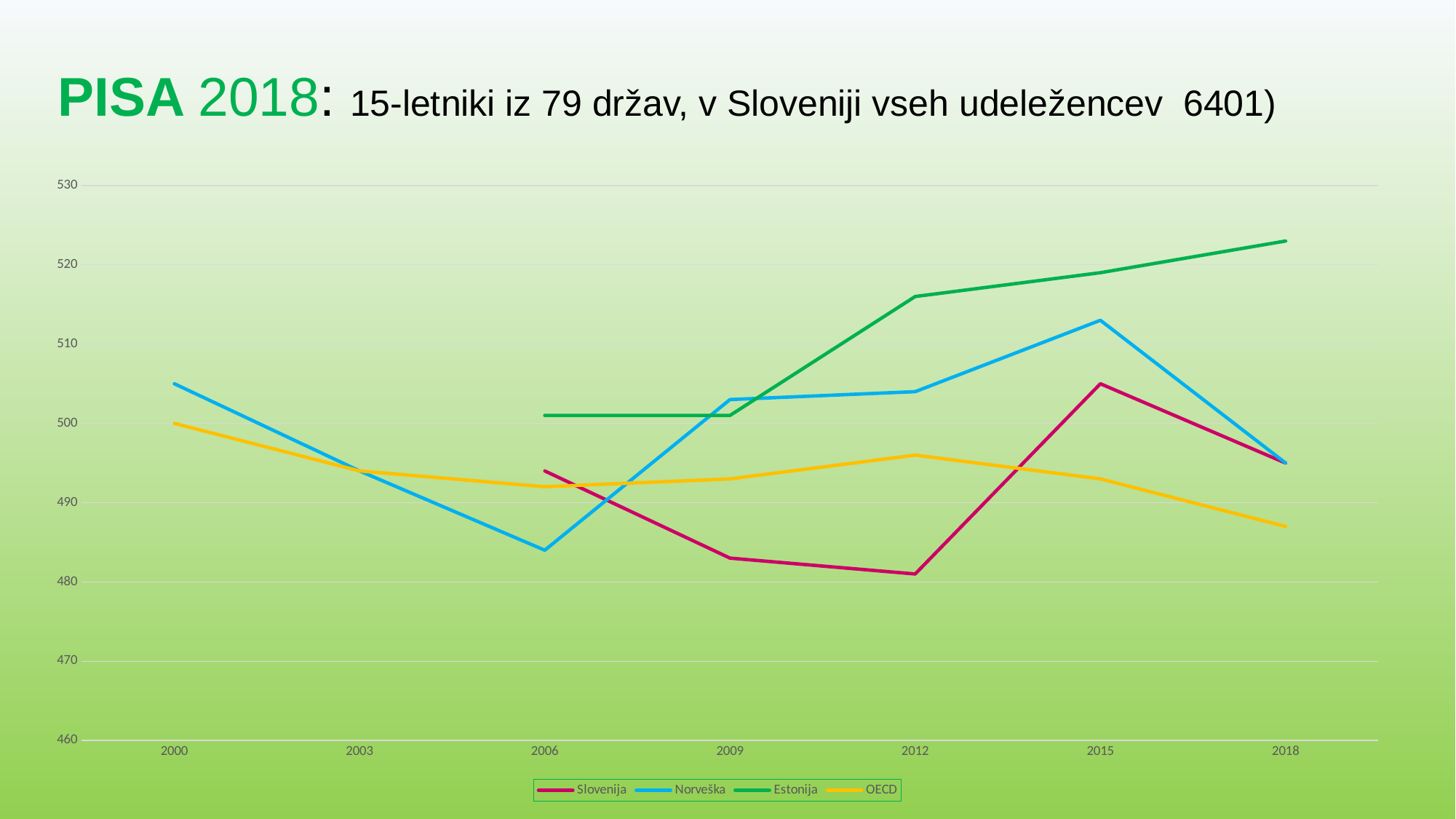
Does the Estonija line rise or fall from 2006 to 2018? rise Is the value for Slovenija in 2012 greater or less than 490? less How many series does the legend list? 4 Which series has the highest value in 2018? Estonija In 2009, which is larger: the value for Slovenija or the value for OECD? OECD Which series has the lowest value in 2012? Slovenija Which series has the lowest value in 2018? OECD Which series is drawn in yellow? OECD How many years are shown on the x axis? 7 Is the value for Estonija in 2018 greater or less than 520? greater What kind of chart is shown on the slide? line chart Is the value for Norveška in 2006 greater or less than 490? less